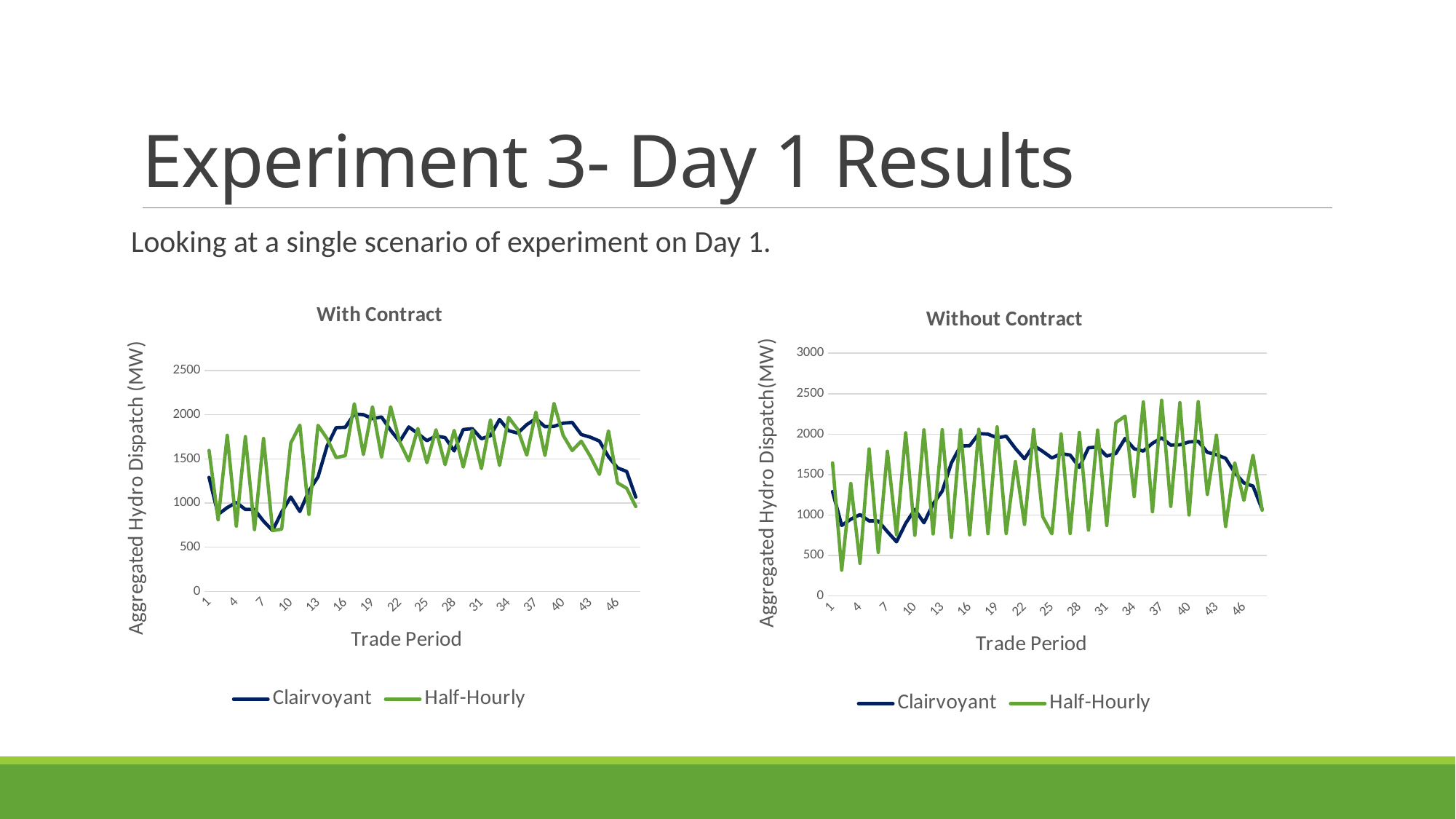
What are the two series named in the legend of the "With Contract" chart? Clairvoyant and Half-Hourly How many series does the legend of the "Without Contract" chart list? 2 In the "Without Contract" chart, is the lowest value of the Half-Hourly series greater or less than 500? less In the "With Contract" chart, does the Clairvoyant series rise or fall from trade period 40 to the end of the x axis? fall In the "Without Contract" chart, is the Clairvoyant value at trade period 1 greater or less than 1500? less In the "With Contract" chart, is the Clairvoyant value at trade period 1 greater or less than 1500? less In the "With Contract" chart, does the Clairvoyant series rise or fall between trade period 10 and trade period 16? rise What is the y-axis label on the "Without Contract" chart? Aggregated Hydro Dispatch(MW) What type of chart is the "With Contract" chart? Line chart